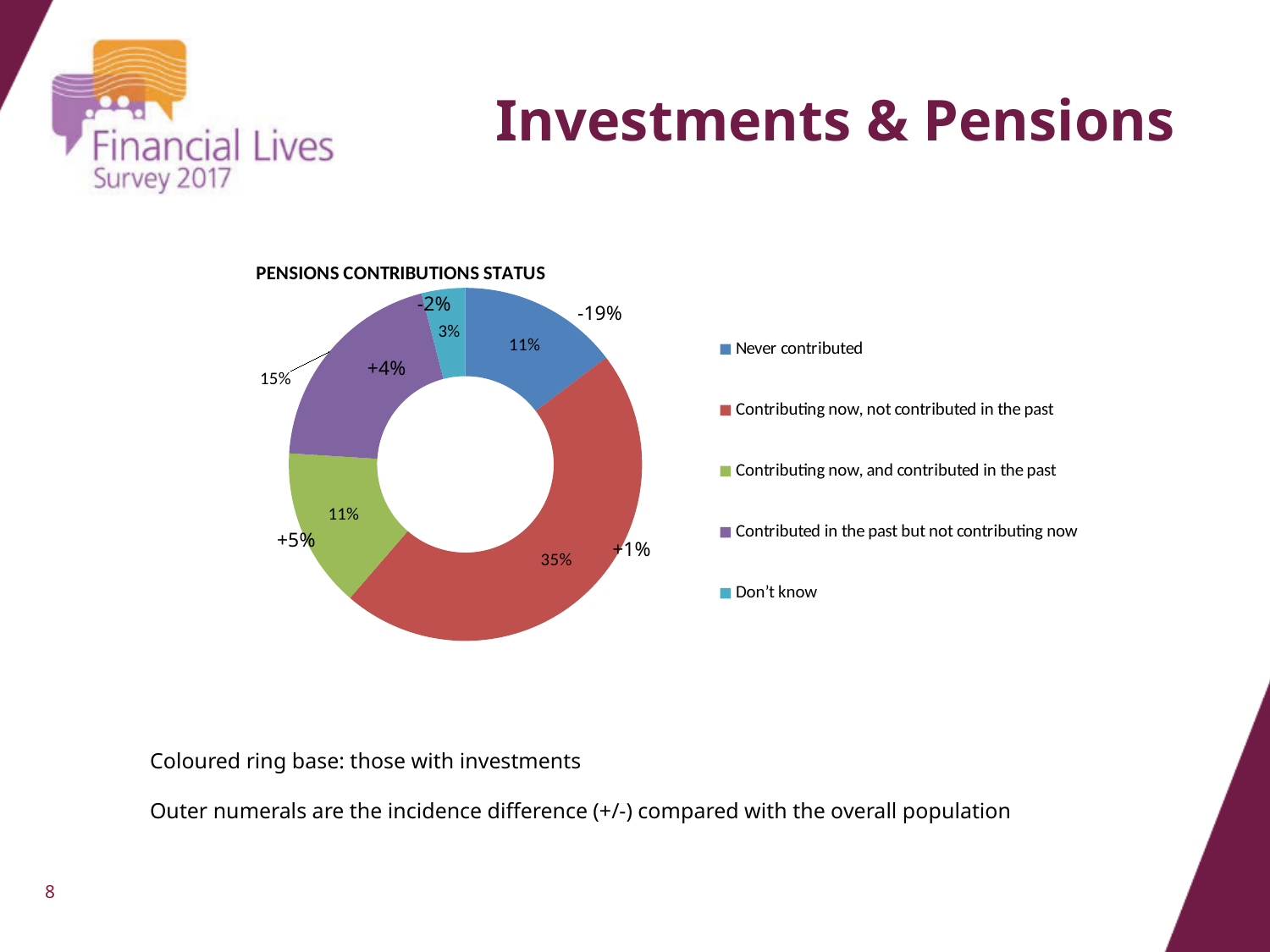
What is the difference between the shares for 'Contributing now, not contributed in the past' and 'Contributed in the past but not contributing now'? 20% Which is larger: the share for 'Contributed in the past but not contributing now' or the share for 'Don't know'? Contributed in the past but not contributing now How many categories does the legend of the chart list? 5 What kind of chart is shown on the slide? Doughnut (pie) chart What is the title of the chart on the slide? PENSIONS CONTRIBUTIONS STATUS What percentage is shown for 'Contributed in the past but not contributing now'? 15% Which category has the largest share of the ring? Contributing now, not contributed in the past What percentage is shown for 'Never contributed'? 11% What percentage is shown for 'Don't know'? 3% Which category has the smallest share of the ring? Don't know What is the outer incidence-difference numeral shown next to the 'Never contributed' segment? -19% What percentage of the ring is labelled for 'Contributing now, not contributed in the past'? 35%